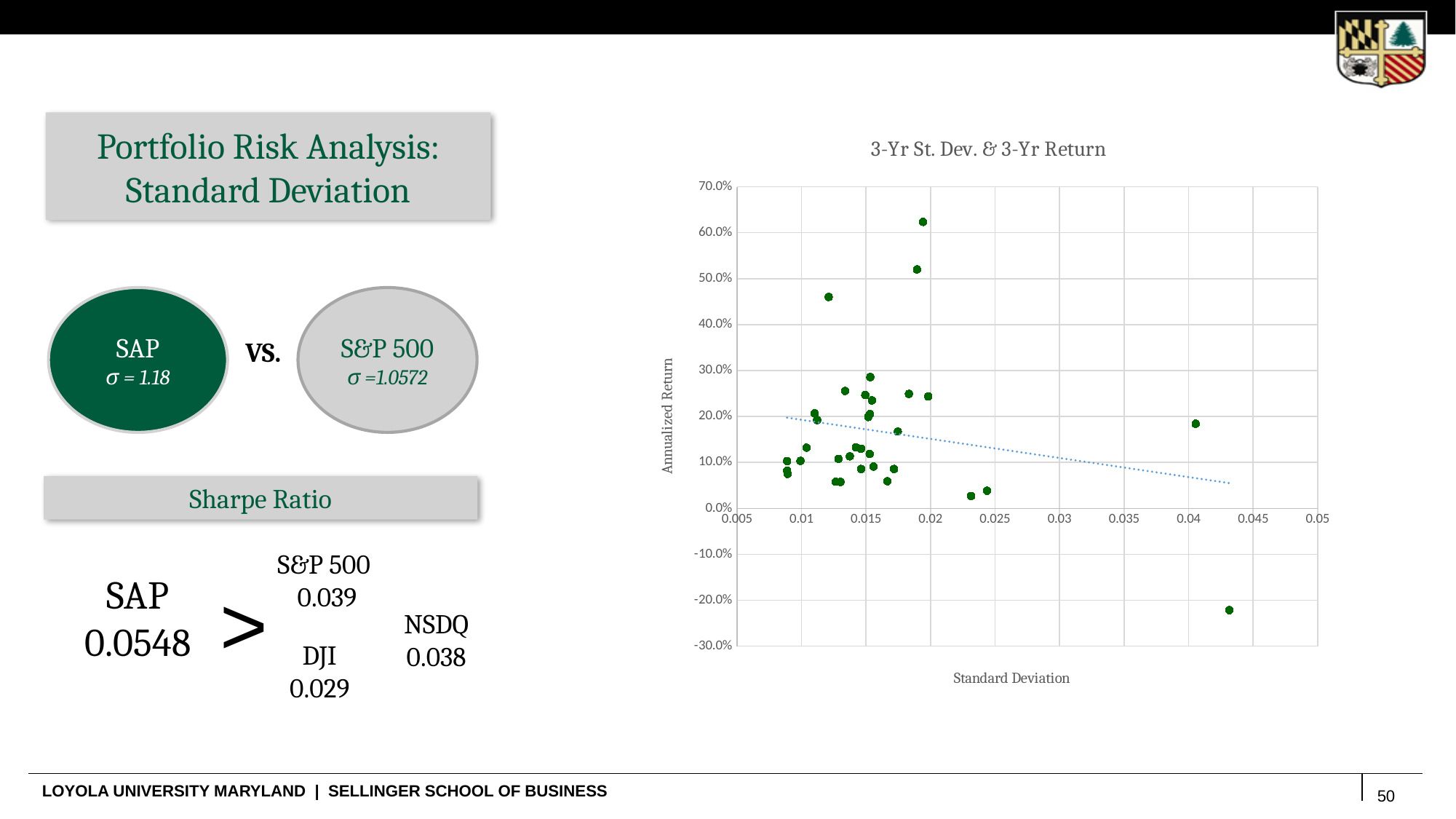
What is the label of the horizontal axis of the chart? Standard Deviation Is the lowest plotted annualized return in the chart greater or less than -10%? less Is the standard deviation of the point with the highest annualized return greater or less than 0.025? less What kind of chart is shown on the slide? Scatter chart Does the dotted trend line in the chart rise or fall as standard deviation increases? Fall How many points in the chart have a negative annualized return? 1 Is the annualized return of the point plotted near a standard deviation of 0.04 greater or less than 10%? greater What is the title of the chart? 3-Yr St. Dev. & 3-Yr Return How many points in the chart have a standard deviation greater than 0.03? 2